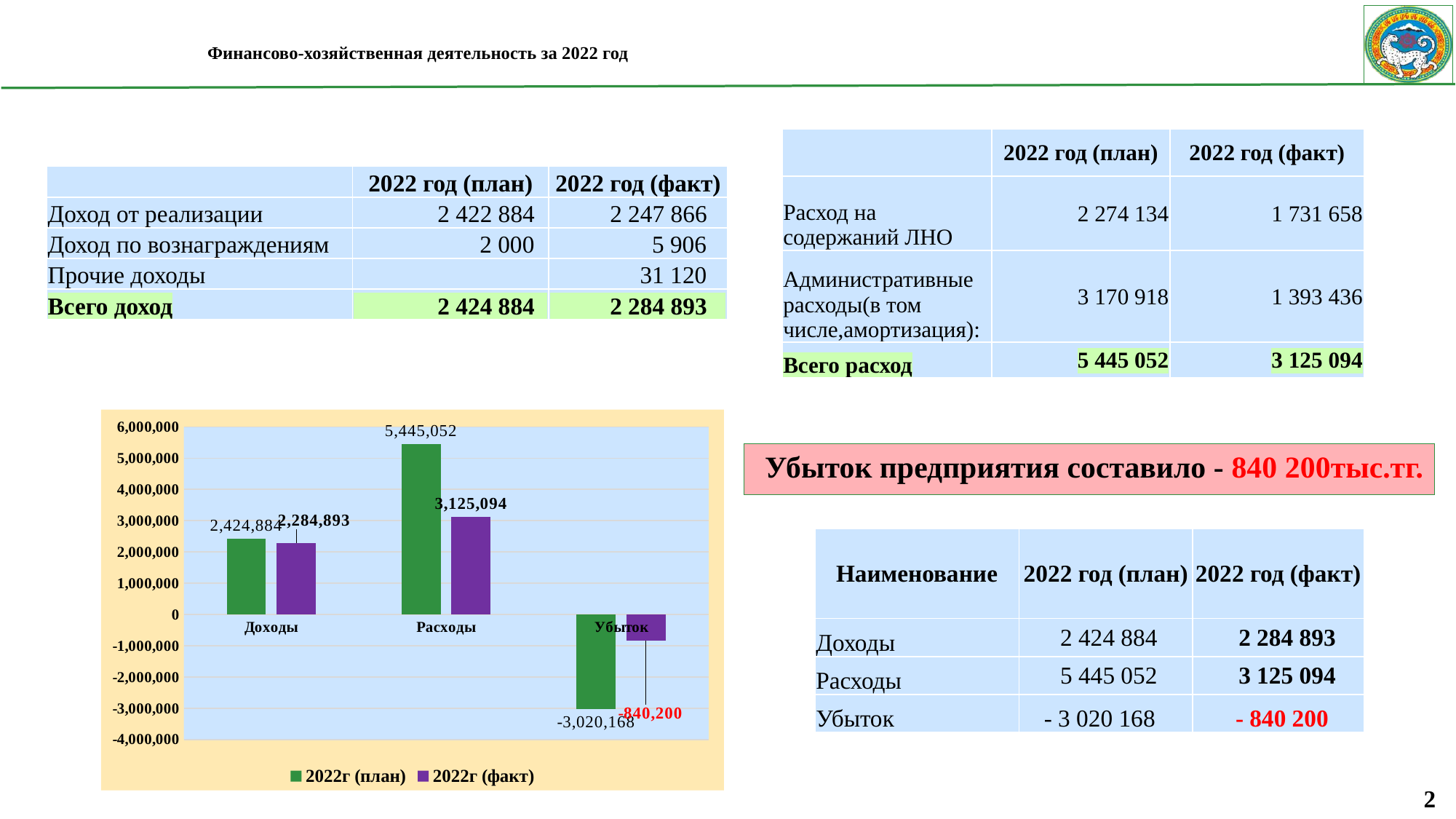
Which series in the chart is shown in purple? 2022г (факт) Which category has the lowest 2022г (факт) value in the chart? Убыток What is the value of the 2022г (план) bar for Убыток? -3,020,168 Which category has the highest 2022г (план) value in the chart? Расходы What is the value of the 2022г (план) bar for Расходы? 5,445,052 What is the difference between the 2022г (план) and 2022г (факт) values for Расходы? 2,319,958 How many series does the chart legend list? 2 What is the value of the 2022г (факт) bar for Убыток? -840,200 What kind of chart is shown on the slide? bar chart Which is larger for Доходы: the 2022г (план) value or the 2022г (факт) value? 2022г (план) What is the value of the 2022г (факт) bar for Доходы? 2,284,893 How many categories are shown on the x axis of the chart? 3